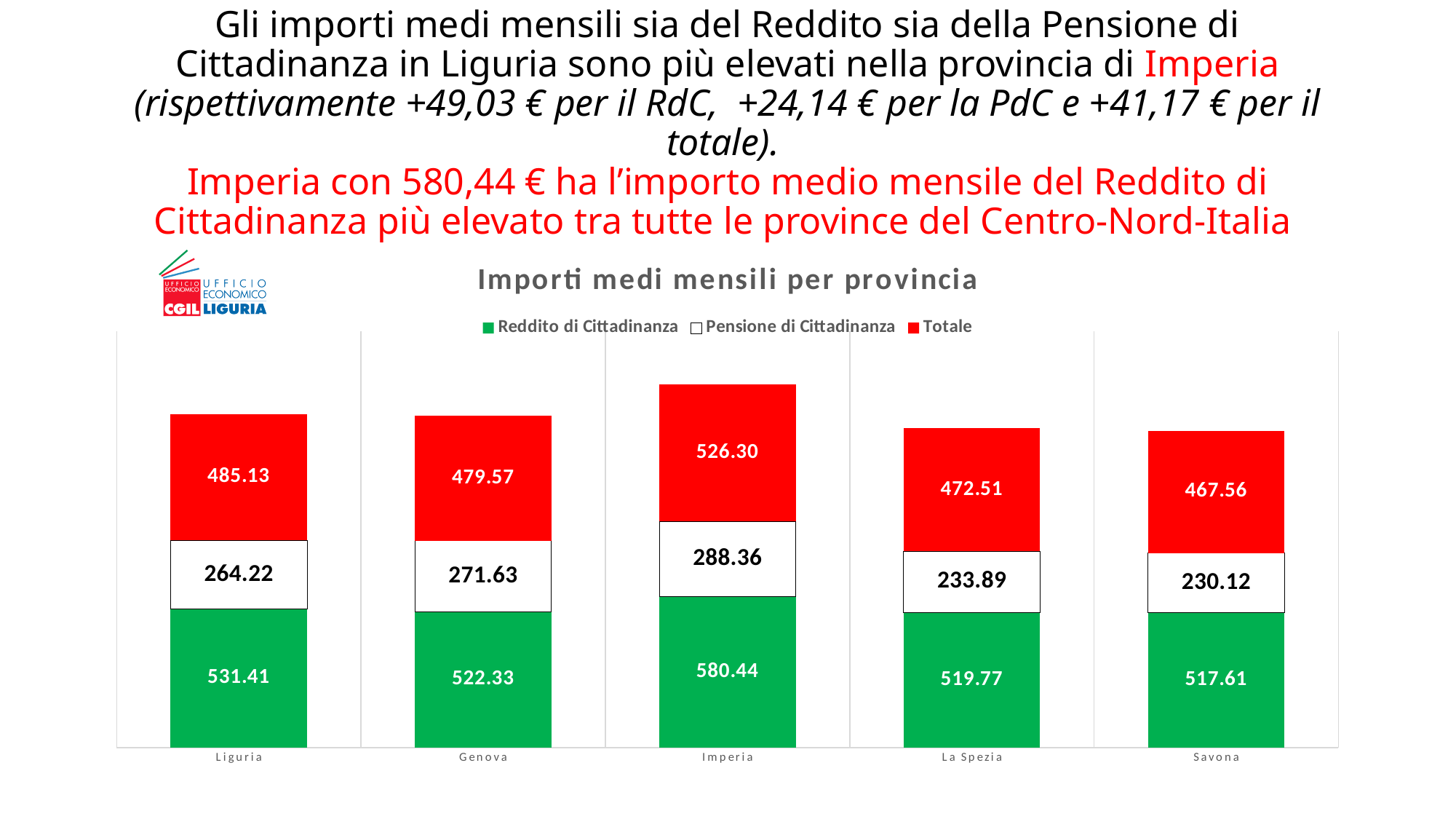
How many categories are shown on the x axis? 5 Which category has the lowest Totale value? Savona What kind of chart is shown on the slide? Stacked bar chart Which province has the highest Reddito di Cittadinanza value? Imperia What is the Reddito di Cittadinanza value for Imperia? 580.44 What is the difference between the Totale values for Imperia and Liguria? 41.17 What is the Pensione di Cittadinanza value for La Spezia? 233.89 What is the difference between the Reddito di Cittadinanza values for Imperia and Liguria? 49.03 How many series does the legend list? 3 What is the Totale value for Genova? 479.57 Which category has the lowest Pensione di Cittadinanza value? Savona Which is larger, the Pensione di Cittadinanza value for Genova or for Liguria? Genova